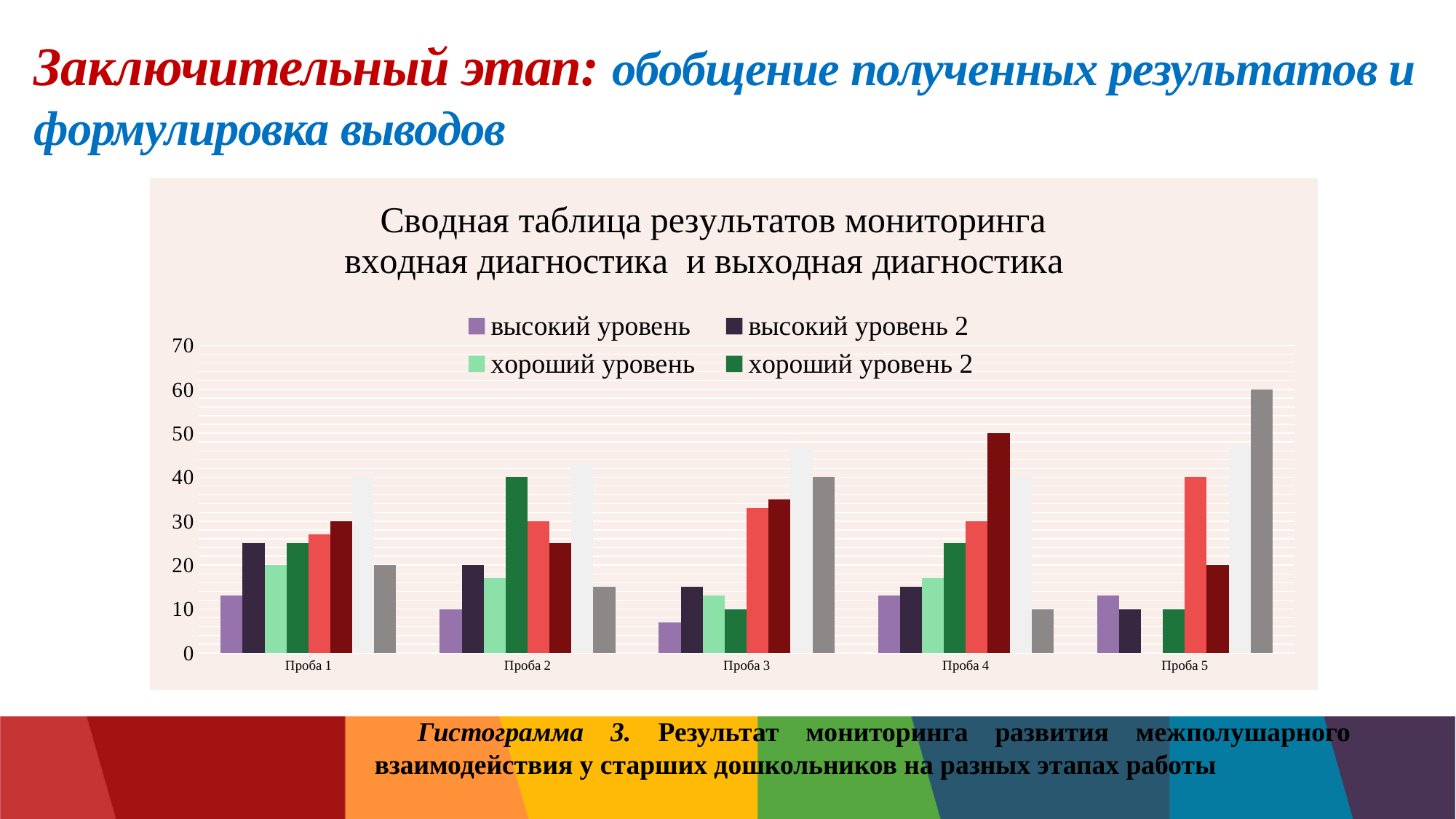
How many series does the legend list? 4 What is the value of 'хороший уровень 2' for Проба 2? 40 What kind of chart is shown on the slide? bar chart For which проба is 'высокий уровень' the lowest? Проба 3 Does 'высокий уровень 2' rise or fall from Проба 1 to Проба 5? fall What is the value of 'высокий уровень' for Проба 2? 10 How many categories (пробы) are shown on the x axis? 5 Is the value of 'хороший уровень 2' for Проба 4 greater or less than 20? greater For Проба 2, which is larger: 'хороший уровень' or 'хороший уровень 2'? хороший уровень 2 For which проба is 'хороший уровень 2' the highest? Проба 2 What is the value of 'хороший уровень' for Проба 1? 20 Is the value of 'высокий уровень' for Проба 1 greater or less than 20? less